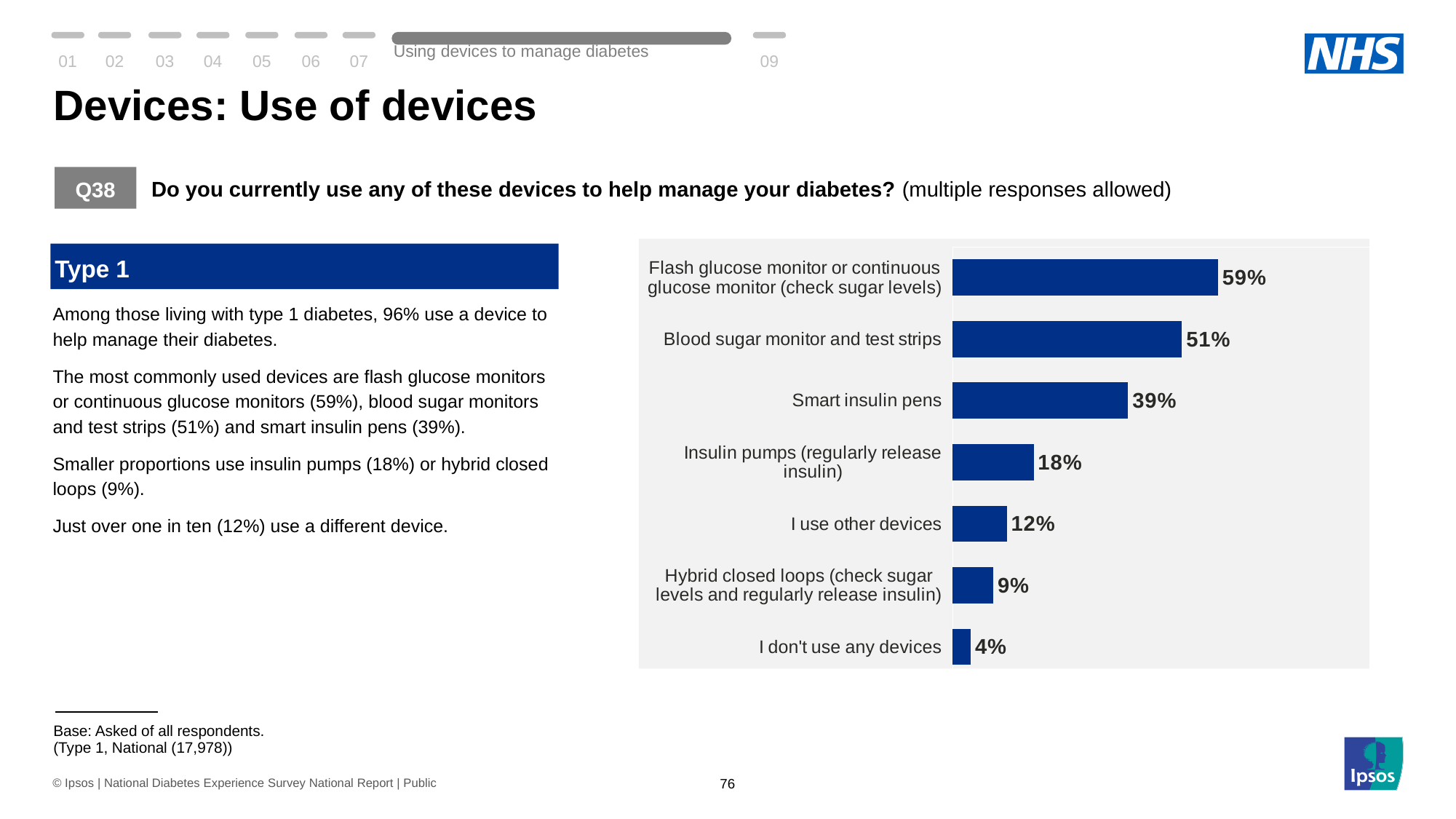
What percentage of respondents use a flash glucose monitor or continuous glucose monitor? 59% Which diabetes type does the chart on this slide cover? Type 1 Which is larger: the percentage for insulin pumps or the percentage for 'I use other devices'? Insulin pumps (regularly release insulin) What percentage of respondents say they don't use any devices? 4% What type of chart is used on this slide? Bar chart What is the difference in percentage points between flash glucose monitor or continuous glucose monitor and smart insulin pens? 20 Which category has the lowest percentage? I don't use any devices How many categories are shown in the chart? 7 What percentage of respondents use smart insulin pens? 39% What percentage of respondents use hybrid closed loops? 9% Which device category has the highest percentage? Flash glucose monitor or continuous glucose monitor (check sugar levels) What is the difference in percentage points between blood sugar monitor and test strips and insulin pumps? 33